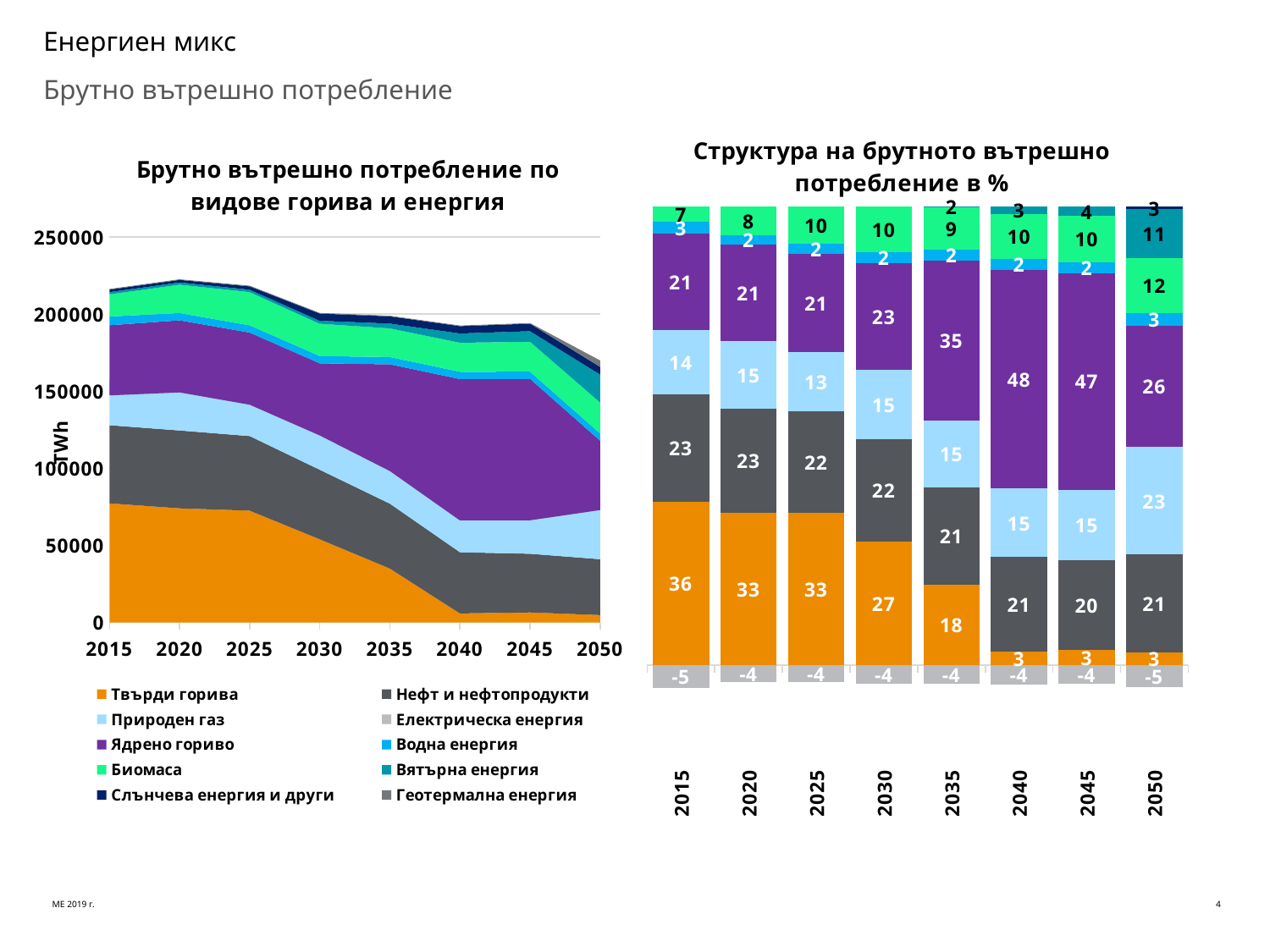
In the right chart, what is the value of the purple (Ядрено гориво) segment for 2040? 48 In the left chart, is the total stacked value for 2015 greater or less than 200000 TWh? greater How many series does the legend of the left chart list? 10 How many years are shown on the x axis of the left chart? 8 In the right chart, which is larger for 2050: the light blue (Природен газ) segment or the dark grey (Нефт и нефтопродукти) segment? Природен газ (23) In the left chart, does the total gross inland consumption rise or fall from 2015 to 2050? fall In the right chart, what is the difference between the purple (Ядрено гориво) segment in 2040 and in 2050? 22 In the right chart, what is the value of the orange (Твърди горива) segment for 2015? 36 In the left chart, is the total stacked value for 2050 greater or less than 200000 TWh? less In the right chart, in which year is the orange (Твърди горива) segment highest? 2015 What kind of chart is the left chart, 'Брутно вътрешно потребление по видове горива и енергия'? stacked area chart What kind of chart is the right chart, 'Структура на брутното вътрешно потребление в %'? stacked bar chart